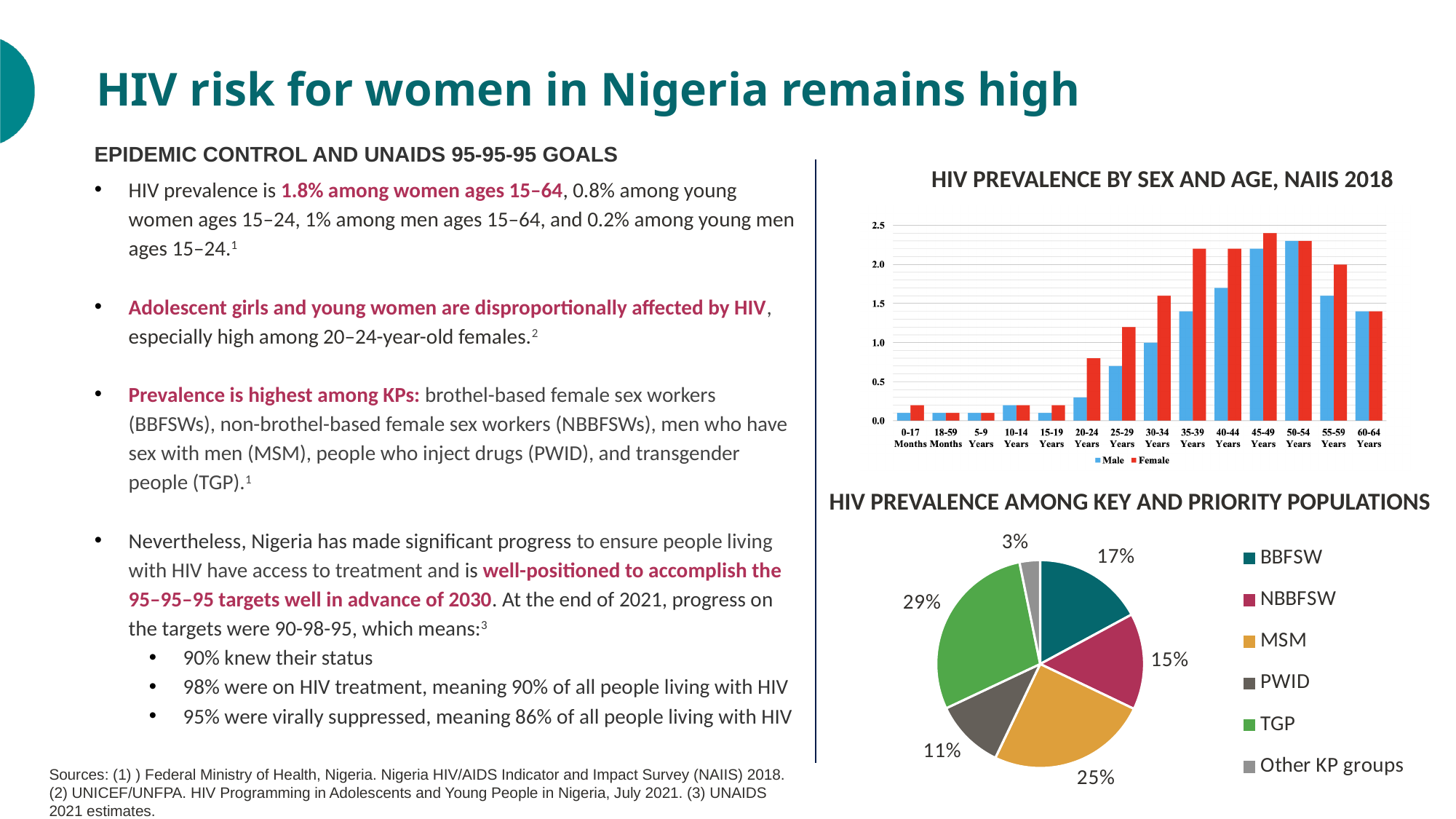
What kind of chart is HIV PREVALENCE BY SEX AND AGE, NAIIS 2018? Bar chart In the HIV PREVALENCE AMONG KEY AND PRIORITY POPULATIONS pie chart, which group has the largest share? TGP In the HIV PREVALENCE BY SEX AND AGE, NAIIS 2018 chart, is the Female value for 35-39 Years greater or less than 2.0? greater In the HIV PREVALENCE BY SEX AND AGE, NAIIS 2018 chart, which is larger for 20-24 Years, Male or Female? Female In the HIV PREVALENCE AMONG KEY AND PRIORITY POPULATIONS pie chart, what share is PWID? 11% In the HIV PREVALENCE AMONG KEY AND PRIORITY POPULATIONS pie chart, what share is MSM? 25% How many series does the legend of the HIV PREVALENCE BY SEX AND AGE, NAIIS 2018 chart list? 2 In the HIV PREVALENCE AMONG KEY AND PRIORITY POPULATIONS pie chart, what is the difference between the BBFSW and NBBFSW shares? 2% In the HIV PREVALENCE AMONG KEY AND PRIORITY POPULATIONS pie chart, what share is TGP? 29% In the HIV PREVALENCE AMONG KEY AND PRIORITY POPULATIONS pie chart, how many slices are there? 6 In the HIV PREVALENCE AMONG KEY AND PRIORITY POPULATIONS pie chart, which group has the smallest share? Other KP groups In the HIV PREVALENCE BY SEX AND AGE, NAIIS 2018 chart, is the Male value for 25-29 Years greater or less than 1.0? less